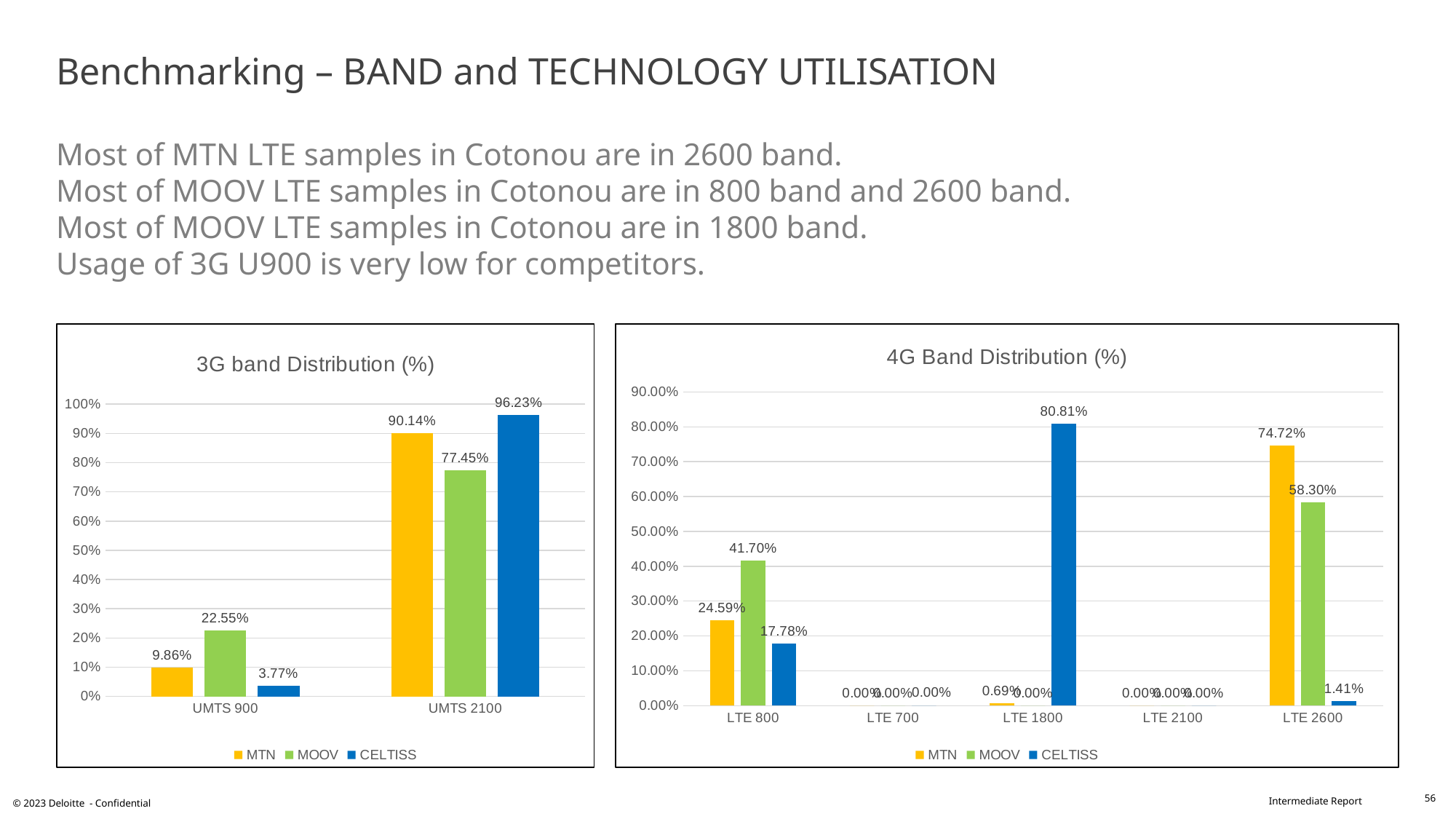
In the 3G band Distribution (%) chart, what is the difference between MTN and MOOV in UMTS 2100? 12.69% In the 4G Band Distribution (%) chart, what is the value for CELTISS in LTE 1800? 80.81% In the 4G Band Distribution (%) chart, is the value for MTN in LTE 2600 larger or smaller than the value for MOOV in LTE 2600? larger In the 3G band Distribution (%) chart, what is the value for MOOV in UMTS 900? 22.55% In the 3G band Distribution (%) chart, which operator has the lowest value in UMTS 900? CELTISS In the 4G Band Distribution (%) chart, which band has the highest value for MTN? LTE 2600 In the 3G band Distribution (%) chart, what is the value for CELTISS in UMTS 2100? 96.23% In the 4G Band Distribution (%) chart, what is the value for MOOV in LTE 800? 41.70% What type of chart is the 4G Band Distribution (%) chart? Bar chart How many band categories are shown on the x axis of the 4G Band Distribution (%) chart? 5 In the 4G Band Distribution (%) chart, what is the difference between MTN and CELTISS in LTE 800? 6.81% In the 3G band Distribution (%) chart, how many series does the legend list? 3